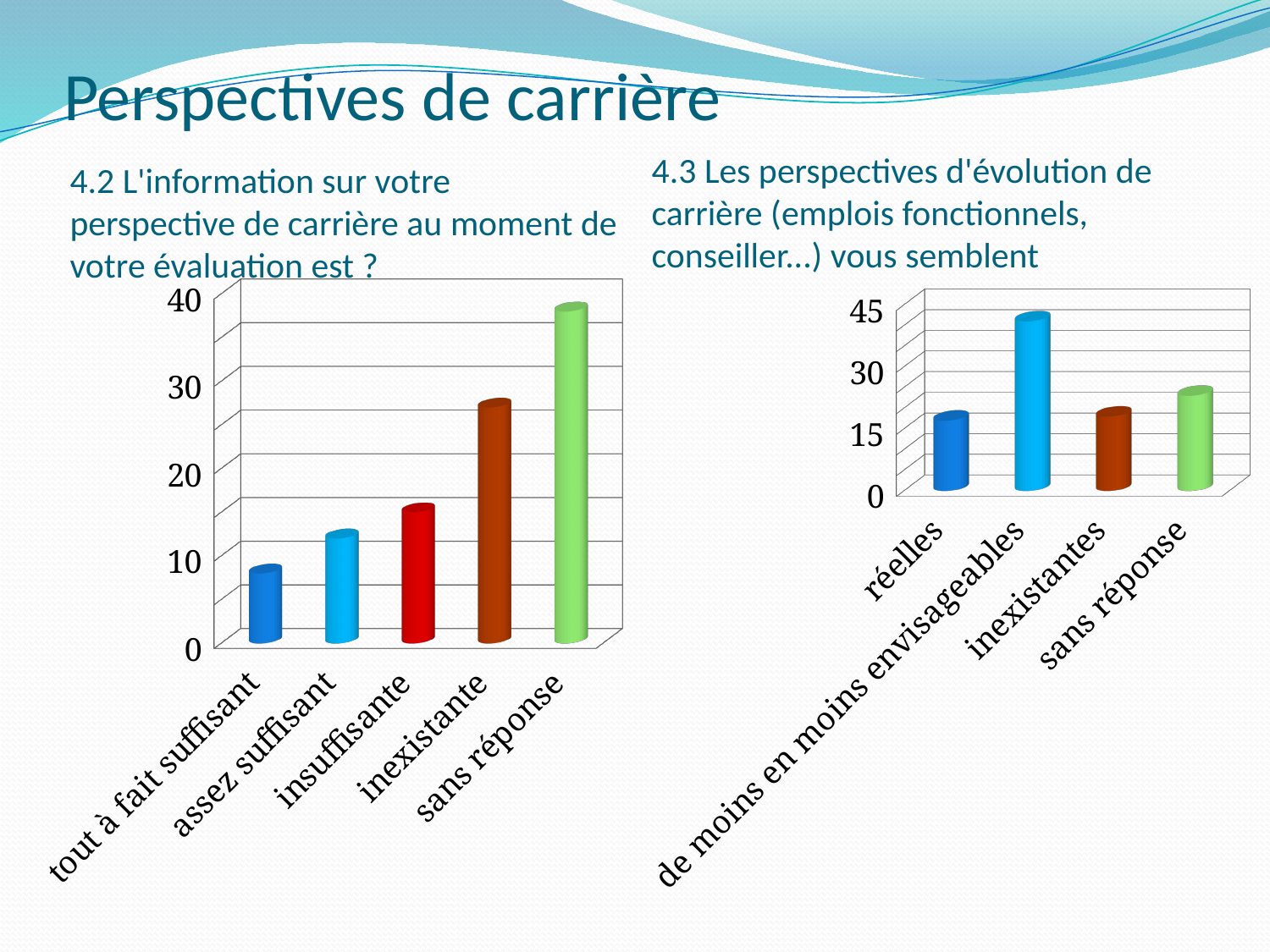
How many categories does the right chart (4.3) show? 4 In the left chart (4.2), which category has the lowest value? tout à fait suffisant In the left chart (4.2), is the value for sans réponse greater or less than 30? greater In the right chart (4.3), is the value for de moins en moins envisageables greater or less than 30? greater In the left chart (4.2), is the value for inexistante greater or less than 20? greater How many categories does the left chart (4.2) show? 5 What kind of chart is the left chart (4.2)? bar chart In the left chart (4.2), which category has the highest value? sans réponse In the right chart (4.3), which category has the highest value? de moins en moins envisageables In the right chart (4.3), which is larger, the value for sans réponse or the value for réelles? sans réponse In the left chart (4.2), do the values rise or fall from left to right along the x axis? rise